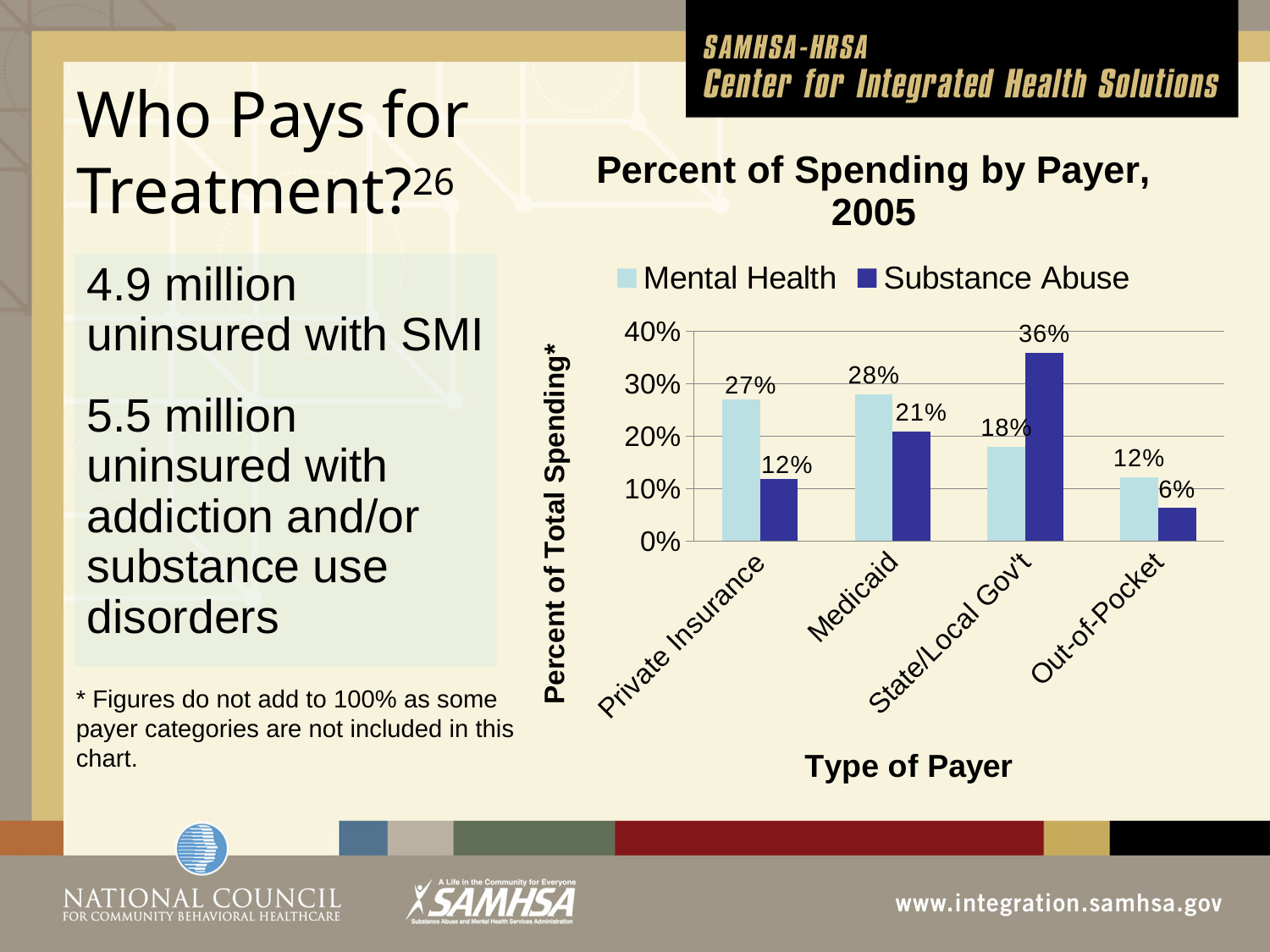
Which payer has the lowest Substance Abuse value? Out-of-Pocket How many series does the legend list? 2 Which payer has the highest Mental Health value? Medicaid What is the Substance Abuse value for Out-of-Pocket? 6% What is the Mental Health value for Private Insurance? 27% What is the difference between the Substance Abuse and Mental Health values for State/Local Gov't? 18% How many payer categories are shown on the x axis? 4 What is the title of the chart? Percent of Spending by Payer, 2005 What is the Substance Abuse value for State/Local Gov't? 36% Is the Substance Abuse value for Private Insurance greater or less than 20%? less What kind of chart is shown? bar chart Which is larger for Medicaid, the Mental Health value or the Substance Abuse value? Mental Health